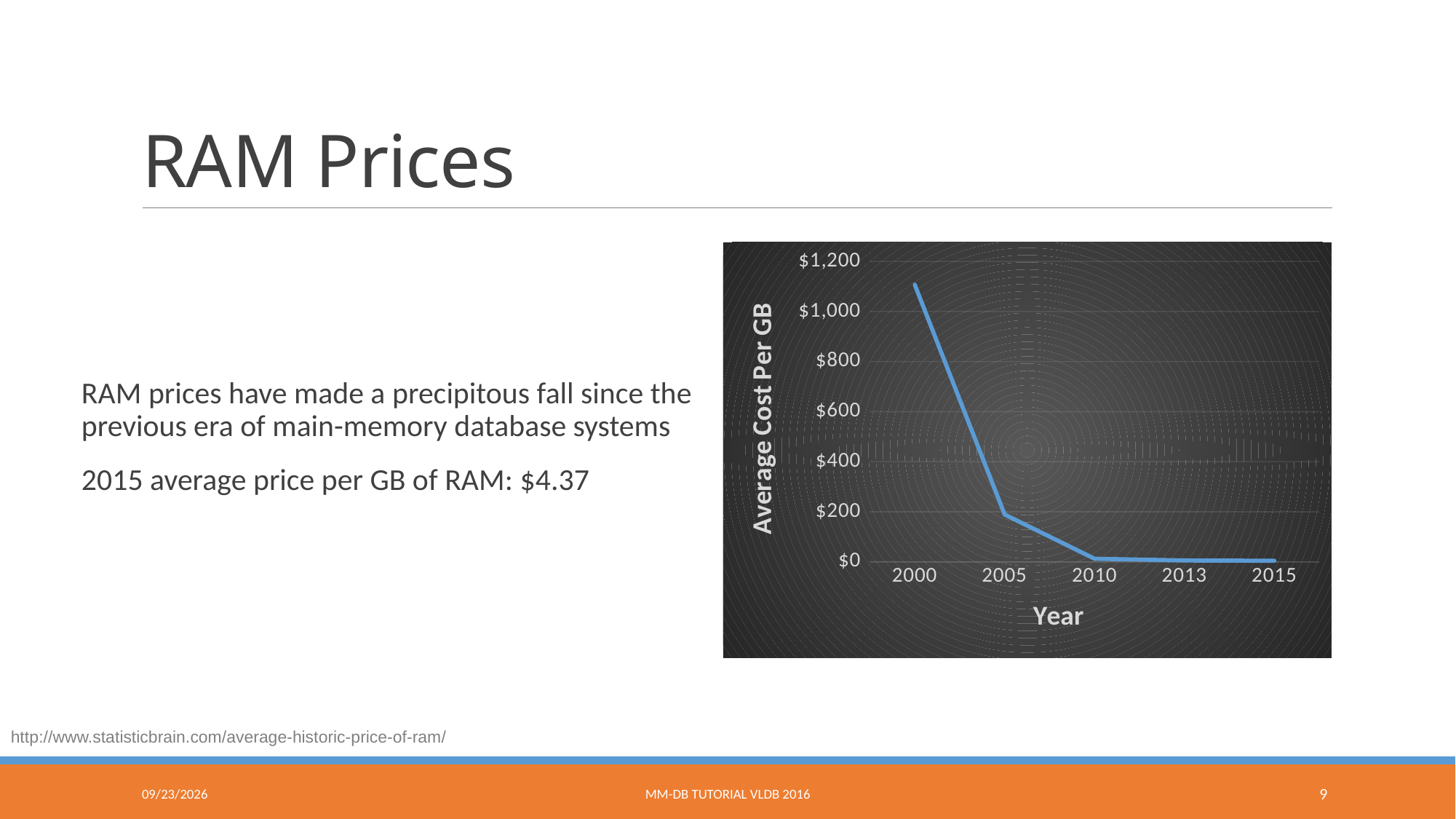
Which year has the larger average cost per GB, 2000 or 2005? 2000 Is the average cost per GB for 2005 greater or less than $400? less What kind of chart is shown on the slide? line chart Which year has the larger average cost per GB, 2005 or 2013? 2005 Do the values in the chart rise or fall from 2000 to 2015? fall Is the average cost per GB for 2010 greater or less than $200? less Is the average cost per GB for 2000 greater or less than $1,000? greater What is the title of the y axis of the chart? Average Cost Per GB How many years are plotted on the x axis of the chart? 5 Which year has the highest average cost per GB in the chart? 2000 What is the title of the x axis of the chart? Year